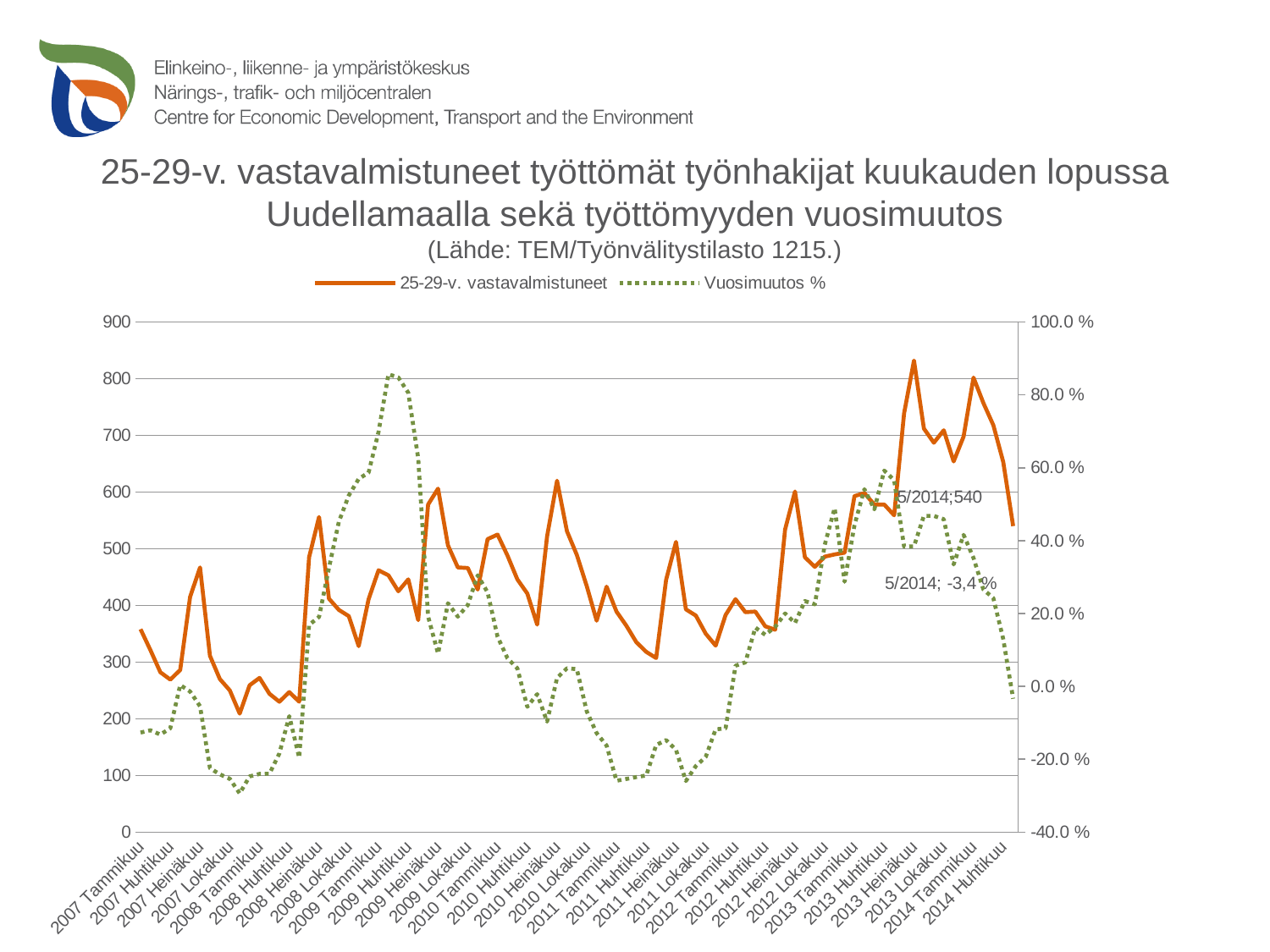
How many series does the legend list? 2 Does the 25-29-v. vastavalmistuneet series rise or fall between 2014 Tammikuu and 5/2014? fall Which is larger for the 25-29-v. vastavalmistuneet series: the value at 2007 Tammikuu or the value at 2013 Tammikuu? 2013 Tammikuu What is the labelled value of the 25-29-v. vastavalmistuneet series for 5/2014? 540 What are the two legend entries of the chart? 25-29-v. vastavalmistuneet; Vuosimuutos % Which series is drawn as a green dotted line? Vuosimuutos % What is the labelled value of the Vuosimuutos % series for 5/2014? -3,4 % What kind of chart is shown on the slide? line chart Is the value of Vuosimuutos % at 2011 Tammikuu greater or less than 0.0 %? less Is the value of 25-29-v. vastavalmistuneet at 2007 Tammikuu greater or less than 300? greater Is the highest value reached by the 25-29-v. vastavalmistuneet series greater or less than 800? greater